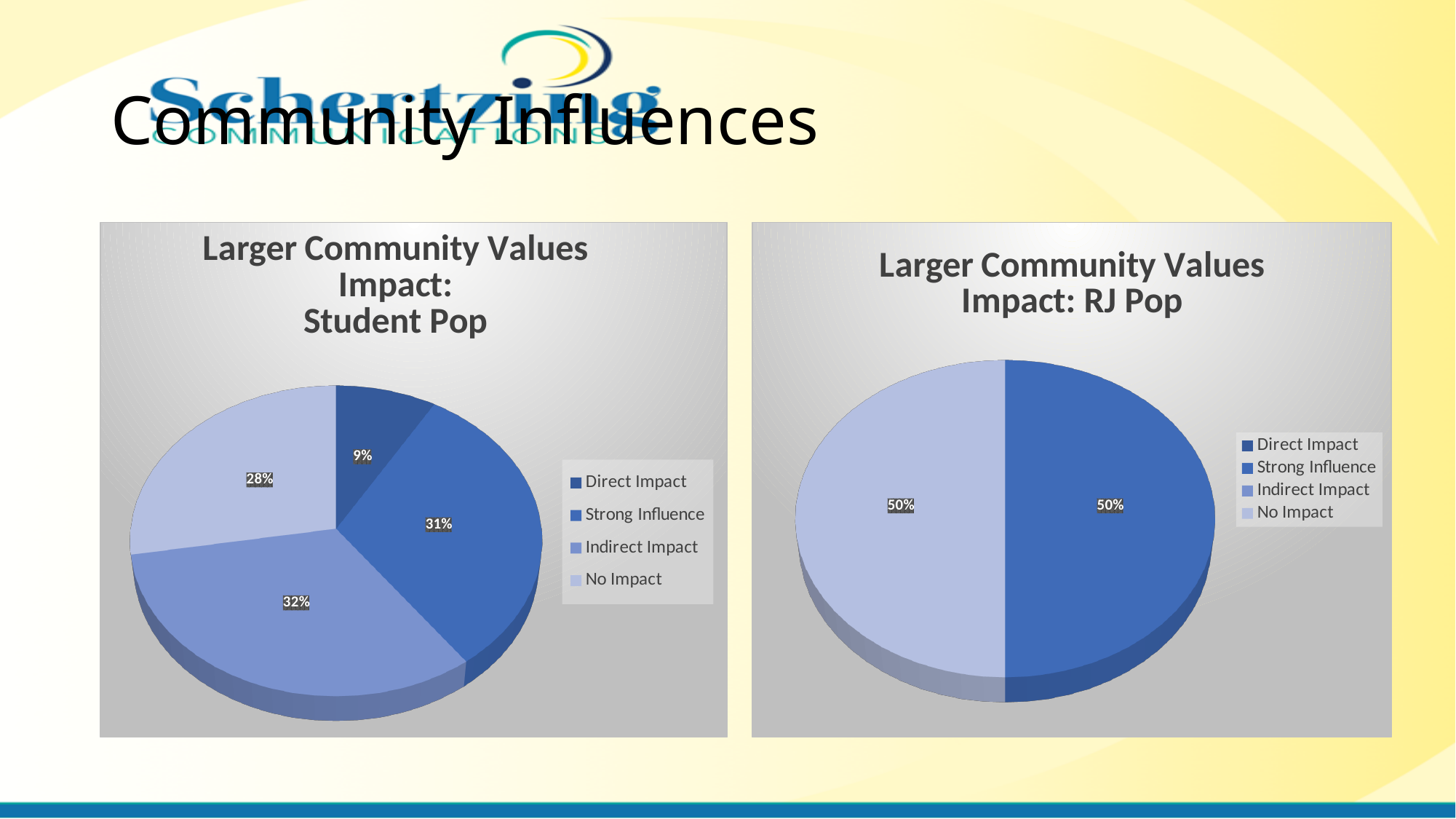
In the 'Larger Community Values Impact: Student Pop' chart, what percentage is shown for No Impact? 28% In the 'Larger Community Values Impact: Student Pop' chart, what percentage is shown for Direct Impact? 9% What type of chart is used on the left side of the slide? Pie chart In the 'Larger Community Values Impact: Student Pop' chart, what is the difference between the Strong Influence and Direct Impact percentages? 22% How many slices are visible in the 'Larger Community Values Impact: RJ Pop' pie chart? 2 How many entries does the legend of the 'Larger Community Values Impact: Student Pop' chart list? 4 In the 'Larger Community Values Impact: Student Pop' chart, which category has the smallest share? Direct Impact In the 'Larger Community Values Impact: Student Pop' chart, which is larger, Strong Influence or No Impact? Strong Influence In the 'Larger Community Values Impact: RJ Pop' chart, what percentage is shown for No Impact? 50% In the 'Larger Community Values Impact: Student Pop' chart, which category has the largest share? Indirect Impact In the 'Larger Community Values Impact: RJ Pop' chart, what percentage is shown for Strong Influence? 50% In the 'Larger Community Values Impact: Student Pop' chart, what percentage is shown for Indirect Impact? 32%